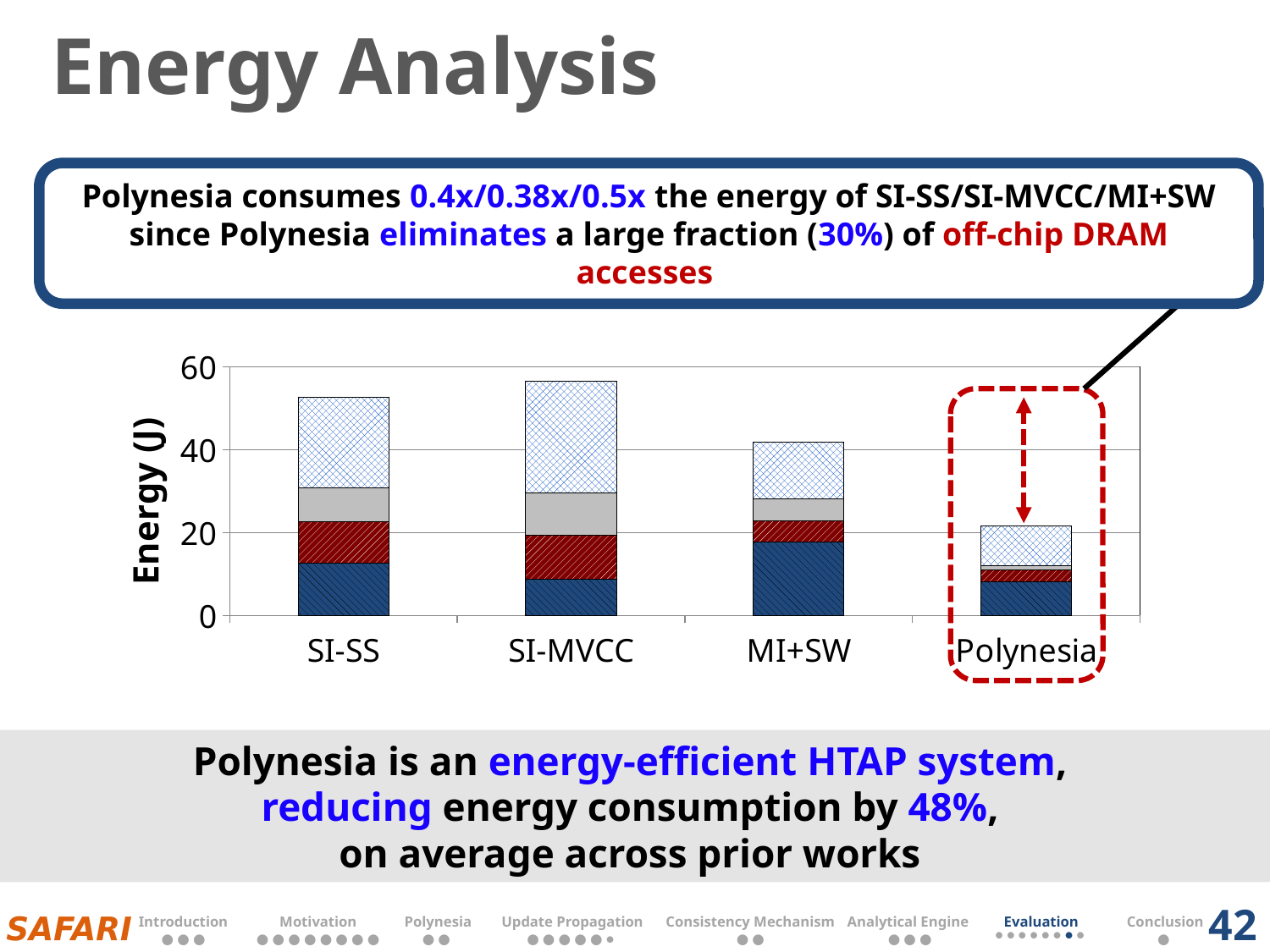
Which has a larger total energy, MI+SW or SI-MVCC? SI-MVCC What is the label of the y axis of the chart? Energy (J) Is the total energy for MI+SW greater or less than 20? greater Which has a larger total energy, SI-SS or Polynesia? SI-SS Is the total energy for SI-SS greater or less than 40? greater Which category has the highest total energy in the chart? SI-MVCC What kind of chart is shown on the slide? stacked bar chart Which category on the chart is highlighted with a red dashed box? Polynesia Is the total energy for SI-MVCC greater or less than 60? less Which category has the lowest total energy in the chart? Polynesia How many categories are shown on the x axis of the chart? 4